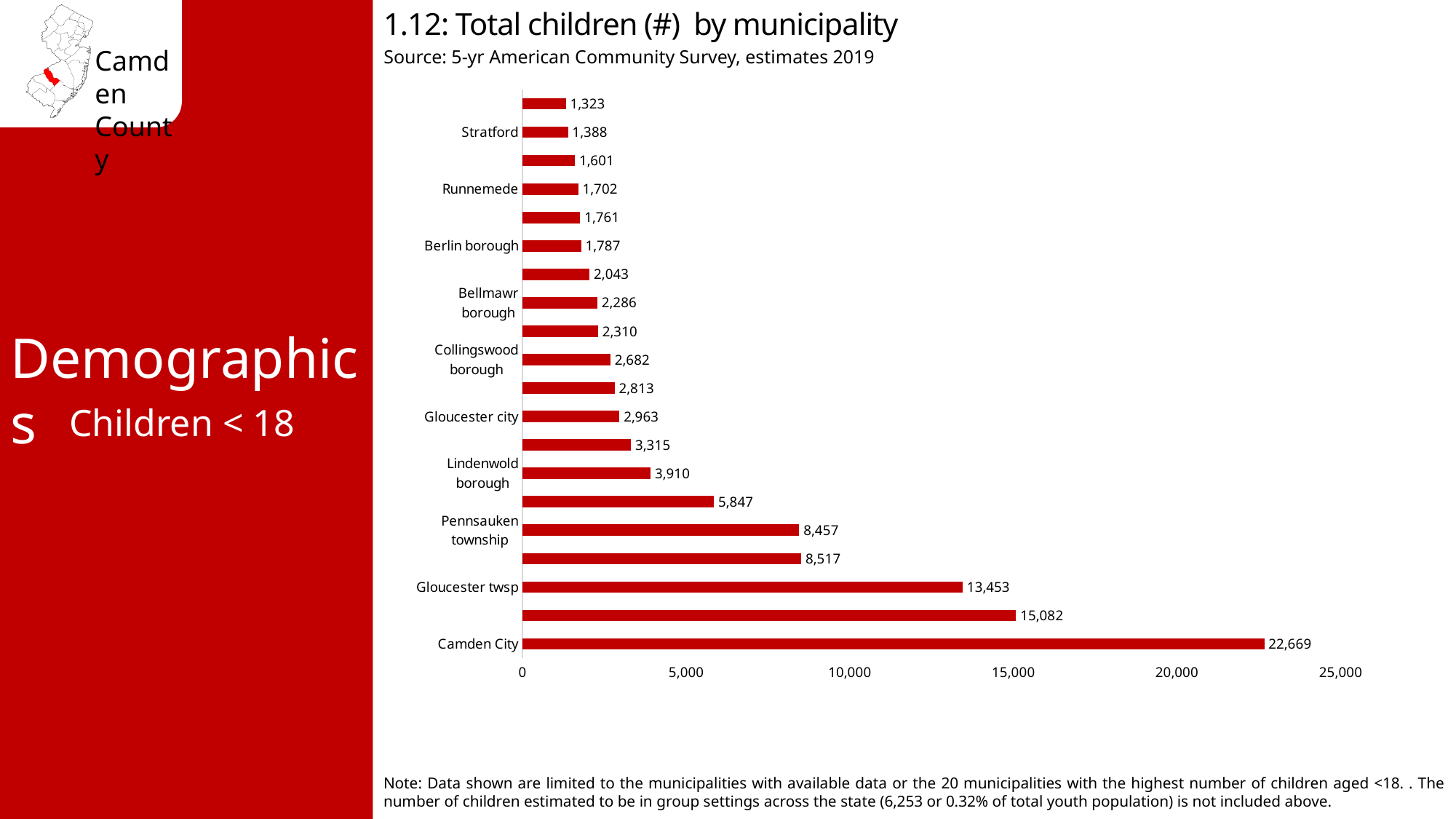
What is the source cited for the chart? 5-yr American Community Survey, estimates 2019 What type of chart is shown on the slide? bar chart What is the value for Gloucester twsp? 13,453 What is the value for Lindenwold borough? 3,910 What is the value for Stratford? 1,388 Which municipality has the highest number of children? Camden City How many children are shown for Camden City? 22,669 What is the difference between Camden City and Gloucester twsp? 9,216 What is the value for Pennsauken township? 8,457 What is the smallest value shown on the chart? 1,323 Which has more children, Collingswood borough or Bellmawr borough? Collingswood borough How many bars are plotted on the chart? 20